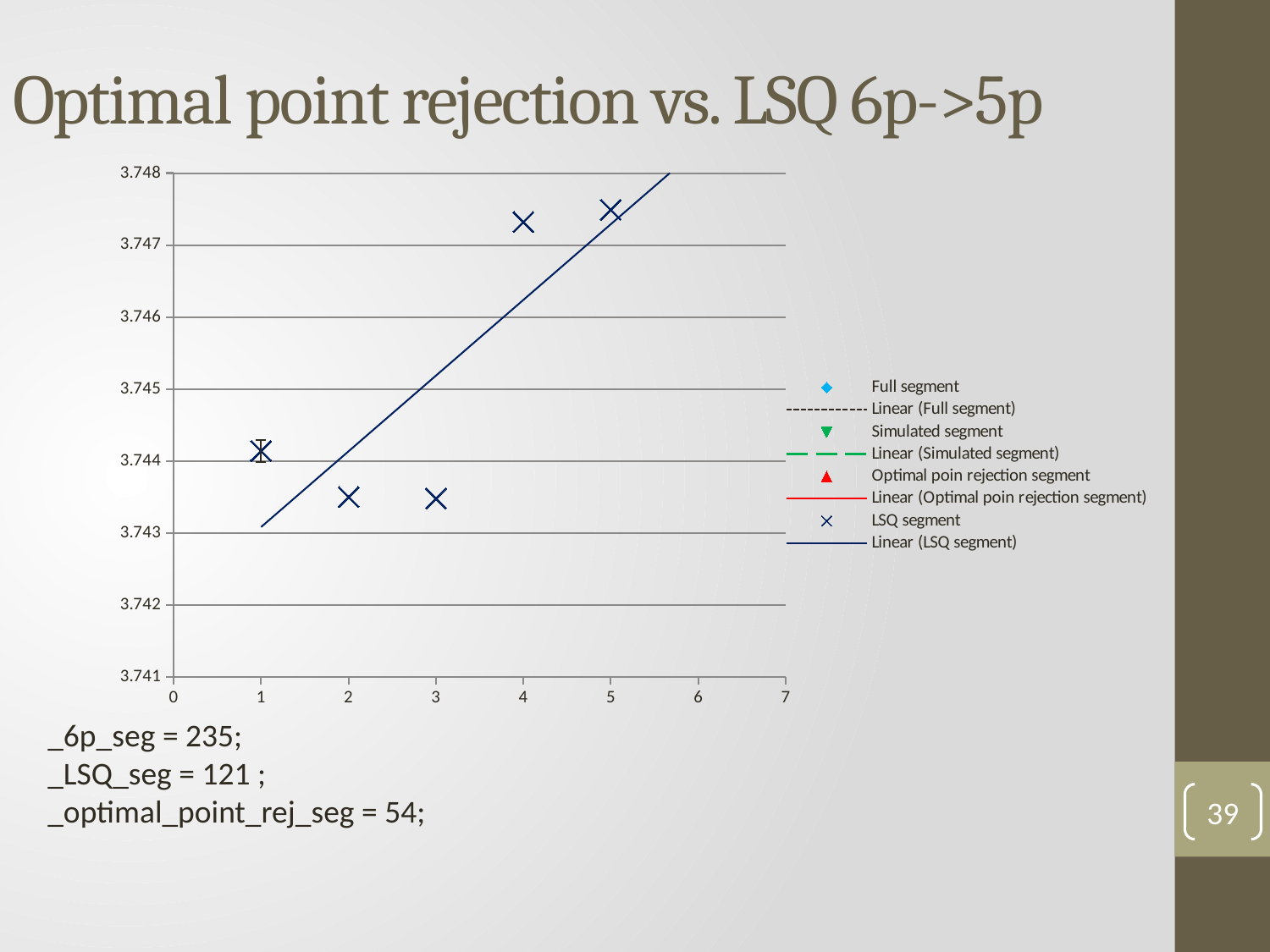
What kind of chart is shown on the slide? scatter chart Which LSQ segment point has the larger value, the one at x = 4 or the one at x = 2? x = 4 Is the LSQ segment value at x = 4 greater or less than 3.747? greater What is the largest value shown on the x axis of the chart? 7 Is the LSQ segment value at x = 5 greater or less than 3.747? greater What is the title of the slide containing the chart? Optimal point rejection vs. LSQ 6p->5p What is the highest value shown on the y axis of the chart? 3.748 Does the linear trendline for the LSQ segment rise or fall as x increases? rise How many entries does the chart legend list? 8 Is the LSQ segment value at x = 3 greater or less than 3.744? less How many LSQ segment data points are plotted on the chart? 5